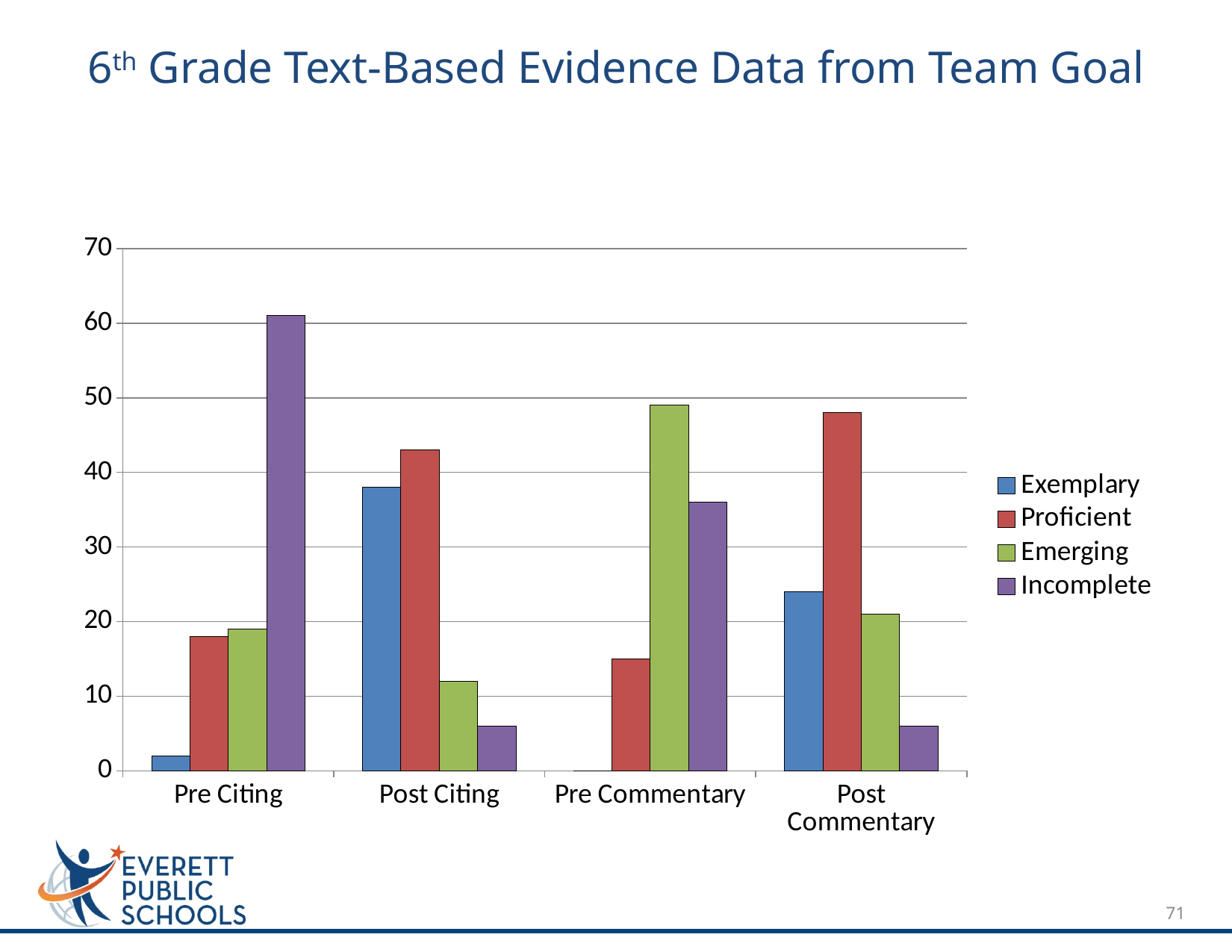
How many categories are shown on the x axis? 4 Is the Exemplary value for Pre Citing greater or less than 10? less Is the Emerging value for Pre Commentary greater or less than 40? greater Which category has the larger Exemplary bar: Post Citing or Post Commentary? Post Citing Is the Incomplete value for Pre Citing greater or less than 50? greater Within the Post Citing category, which series has the lowest bar? Incomplete How many series does the legend list? 4 What kind of chart is shown on the slide? bar chart What colour represents the Emerging series in the legend? green For Post Citing, which is larger: the Exemplary bar or the Proficient bar? Proficient Which category has the highest Incomplete bar? Pre Citing